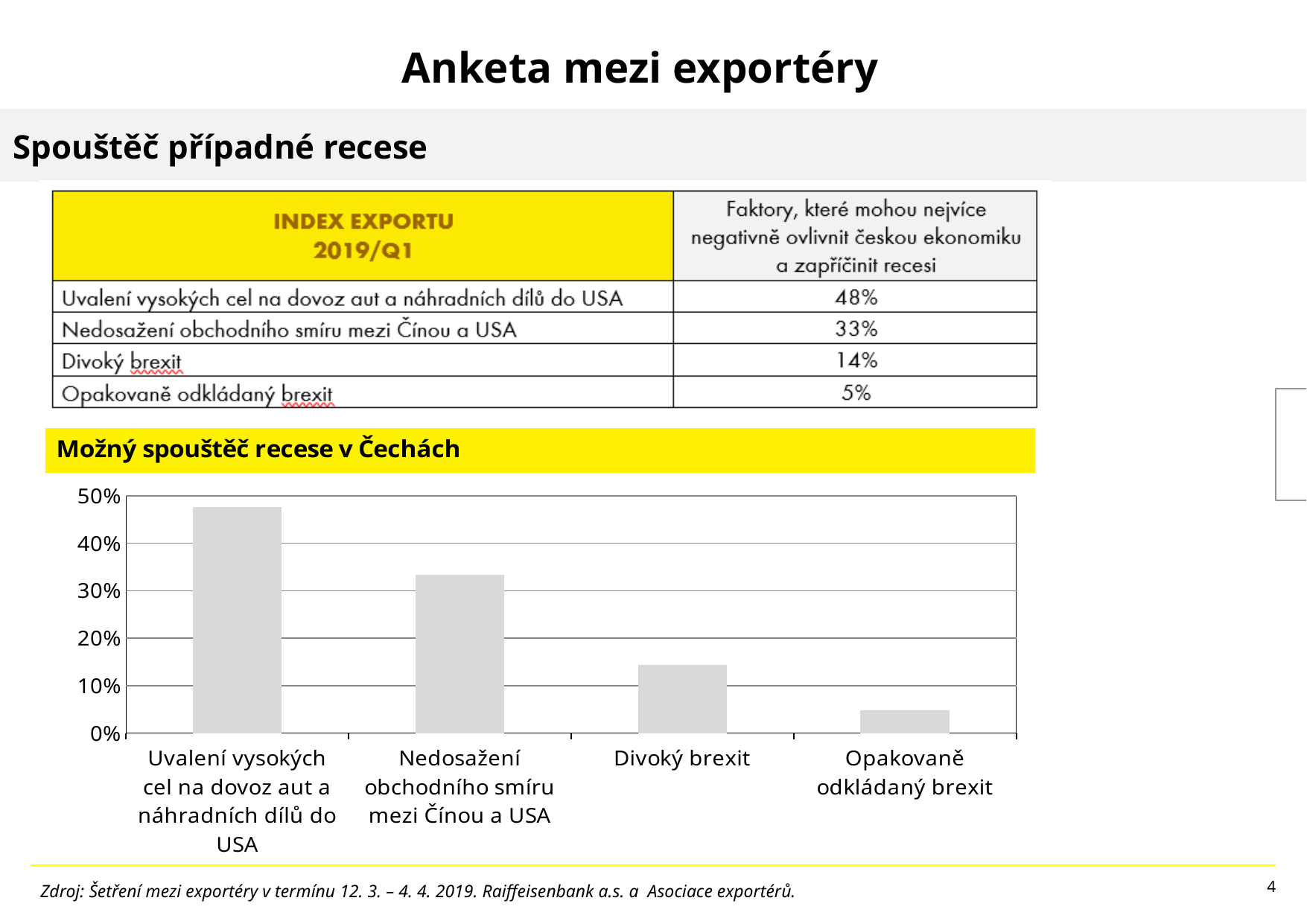
Is the value for 'Divoký brexit' greater or less than 20%? less Is the value for 'Uvalení vysokých cel na dovoz aut a náhradních dílů do USA' greater or less than 40%? greater Which category has the highest bar in the chart? Uvalení vysokých cel na dovoz aut a náhradních dílů do USA Which category has the lowest bar in the chart? Opakovaně odkládaný brexit According to the table on the slide, what share of exporters named 'Divoký brexit' as the factor most likely to cause a recession? 14% Is the value for 'Opakovaně odkládaný brexit' greater or less than 10%? less Do the bar values rise or fall from left to right along the x axis? fall How many categories does the bar chart show? 4 Which is larger: the bar for 'Divoký brexit' or the bar for 'Opakovaně odkládaný brexit'? Divoký brexit What is the highest value shown on the chart's vertical axis? 50% What kind of chart is shown under the heading 'Možný spouštěč recese v Čechách'? bar chart